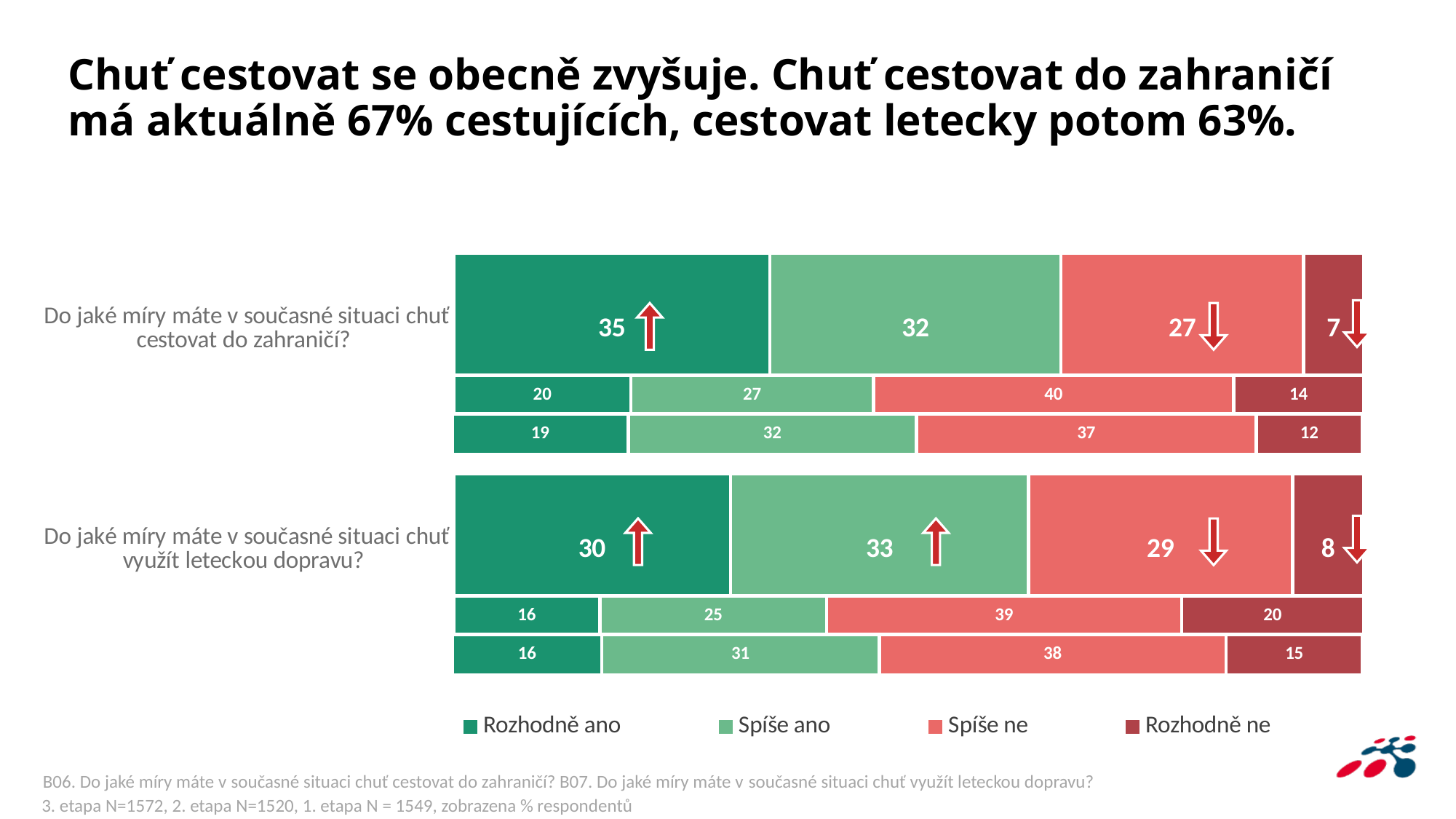
In the large bar for 'Do jaké míry máte v současné situaci chuť cestovat do zahraničí?', what is the difference between 'Rozhodně ano' and 'Spíše ne'? 8 In the large bar for 'Do jaké míry máte v současné situaci chuť využít leteckou dopravu?', which legend category has the highest value? Spíše ano What colour represents 'Rozhodně ne' in the legend? dark red In the lowest bar for 'Do jaké míry máte v současné situaci chuť využít leteckou dopravu?', what is the value for 'Rozhodně ne'? 15 What type of chart is shown on the slide? stacked bar chart Which is larger: 'Rozhodně ano' in the large bar for 'chuť cestovat do zahraničí' or 'Rozhodně ano' in the large bar for 'chuť využít leteckou dopravu'? chuť cestovat do zahraničí In the large bar for 'Do jaké míry máte v současné situaci chuť cestovat do zahraničí?', which legend category has the lowest value? Rozhodně ne In the large bar for 'Do jaké míry máte v současné situaci chuť cestovat do zahraničí?', what is the value for 'Rozhodně ano'? 35 In the large bar for 'Do jaké míry máte v současné situaci chuť využít leteckou dopravu?', what is the combined value of 'Rozhodně ano' and 'Spíše ano'? 63 How many series does the legend list? 4 In the first smaller bar directly below the large bar for 'Do jaké míry máte v současné situaci chuť cestovat do zahraničí?', what is the value for 'Spíše ne'? 40 In the large bar for 'Do jaké míry máte v současné situaci chuť využít leteckou dopravu?', what is the value for 'Spíše ne'? 29